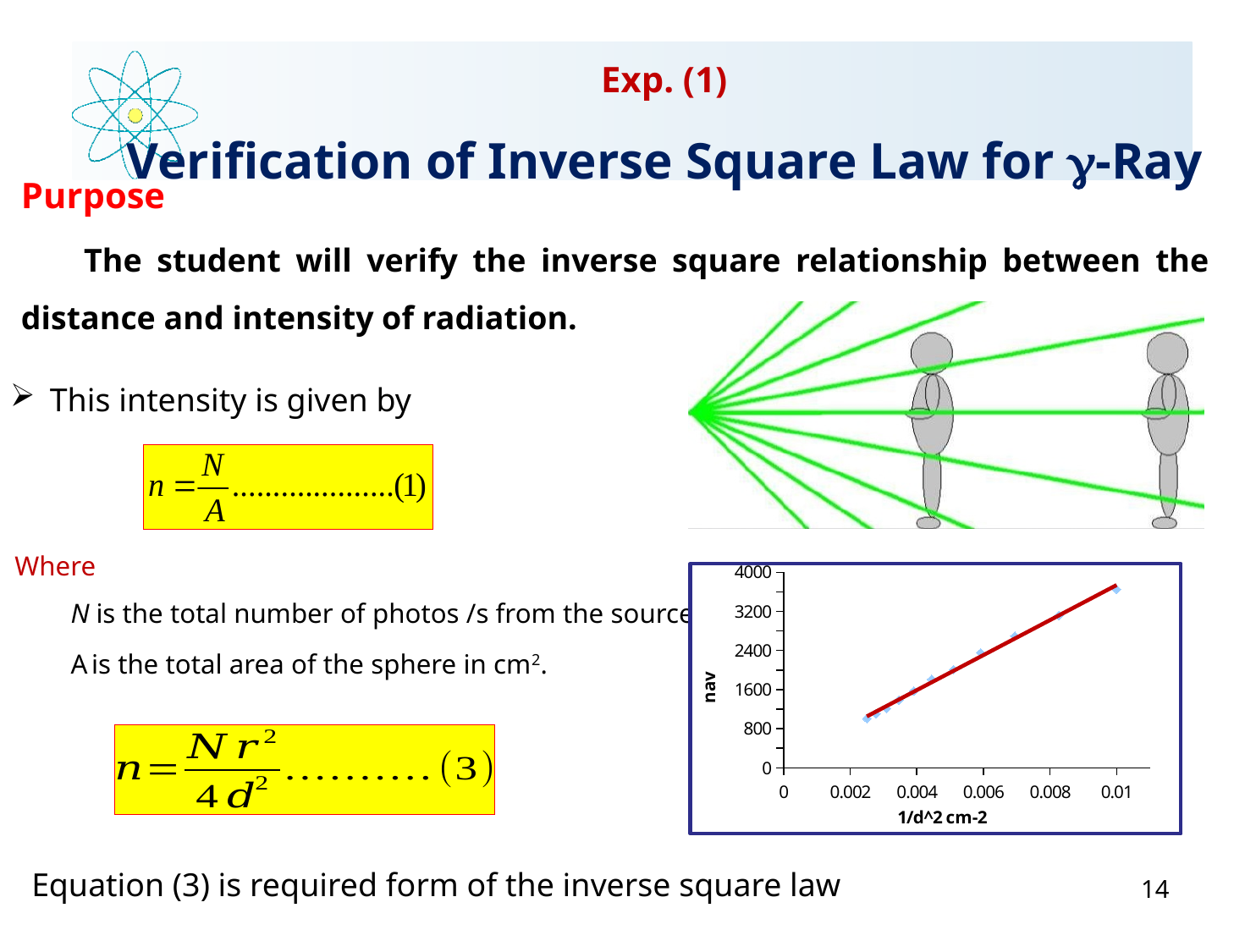
Is the nav value at 1/d^2 = 0.01 greater or less than 3200? greater What is the highest tick value shown on the y axis of the chart? 4000 Which data point has the highest nav value: the one at 1/d^2 = 0.01 or the one at 1/d^2 = 0.0025? the one at 0.01 What kind of chart is shown on the slide? scatter chart What is the label of the y axis of the chart? nav Is the nav value at 1/d^2 = 0.005 greater or less than 2400? less Is the nav value at 1/d^2 = 0.008 greater or less than 2400? greater What is the label of the x axis of the chart? 1/d^2 cm-2 Do the plotted nav values rise or fall as 1/d^2 increases along the x axis? rise